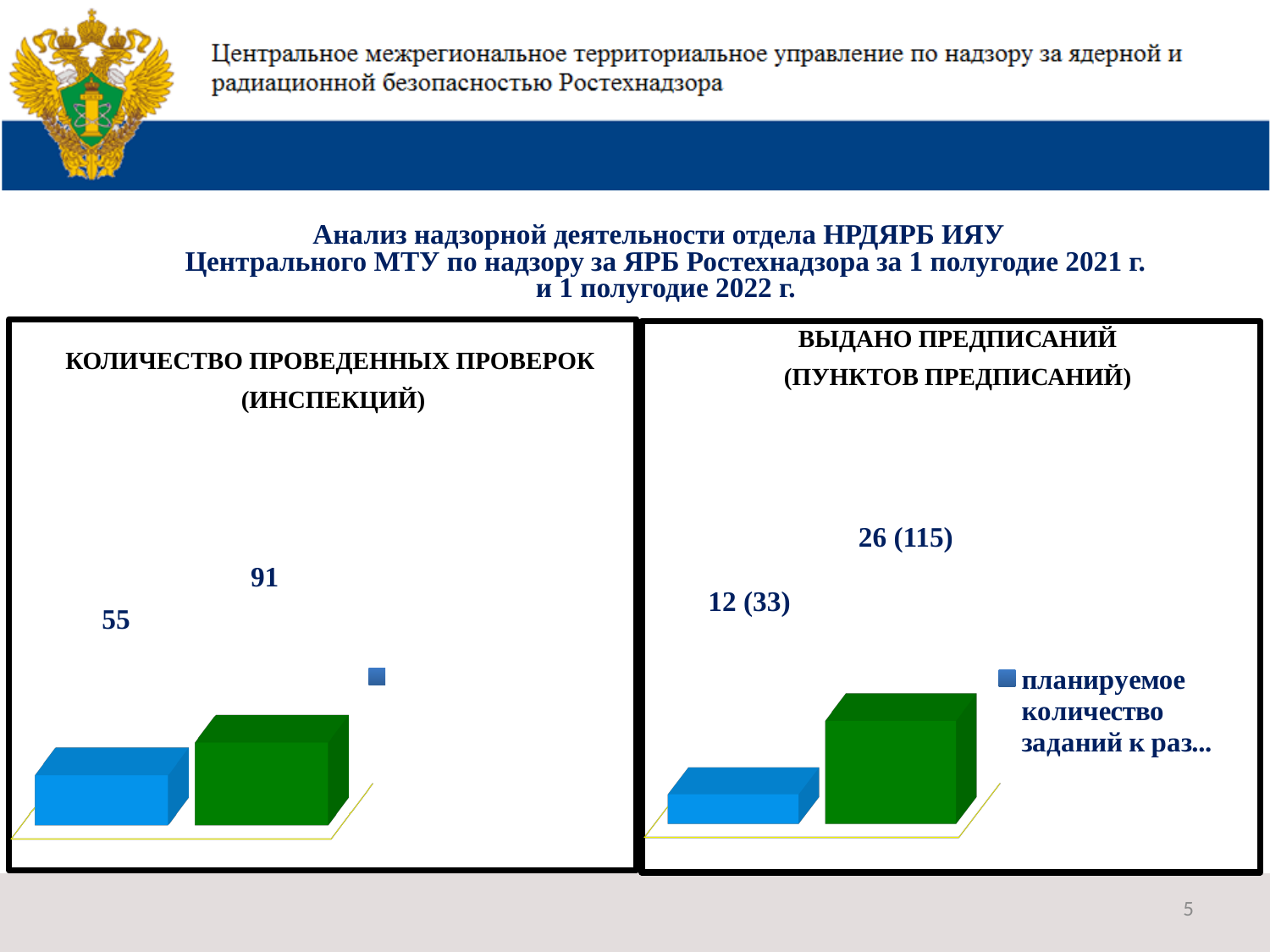
What is the title of the left chart on the slide? КОЛИЧЕСТВО ПРОВЕДЕННЫХ ПРОВЕРОК (ИНСПЕКЦИЙ) In the right chart (ВЫДАНО ПРЕДПИСАНИЙ (ПУНКТОВ ПРЕДПИСАНИЙ)), what is the difference between the number of предписаний on the green bar (26) and on the blue bar (12)? 14 What kind of chart is the left chart (КОЛИЧЕСТВО ПРОВЕДЕННЫХ ПРОВЕРОК (ИНСПЕКЦИЙ))? bar chart How many bars are plotted in the right chart (ВЫДАНО ПРЕДПИСАНИЙ (ПУНКТОВ ПРЕДПИСАНИЙ))? 2 In the left chart (КОЛИЧЕСТВО ПРОВЕДЕННЫХ ПРОВЕРОК (ИНСПЕКЦИЙ)), what is the difference between the green bar and the blue bar? 36 In the left chart (КОЛИЧЕСТВО ПРОВЕДЕННЫХ ПРОВЕРОК (ИНСПЕКЦИЙ)), what value is labelled on the green bar? 91 How many bars are plotted in the left chart (КОЛИЧЕСТВО ПРОВЕДЕННЫХ ПРОВЕРОК (ИНСПЕКЦИЙ))? 2 In the right chart (ВЫДАНО ПРЕДПИСАНИЙ (ПУНКТОВ ПРЕДПИСАНИЙ)), which bar is larger, the blue one or the green one? the green bar In the left chart (КОЛИЧЕСТВО ПРОВЕДЕННЫХ ПРОВЕРОК (ИНСПЕКЦИЙ)), what value is labelled on the blue bar? 55 In the right chart (ВЫДАНО ПРЕДПИСАНИЙ (ПУНКТОВ ПРЕДПИСАНИЙ)), what label is shown on the blue bar? 12 (33) In the right chart (ВЫДАНО ПРЕДПИСАНИЙ (ПУНКТОВ ПРЕДПИСАНИЙ)), what label is shown on the green bar? 26 (115) In the left chart (КОЛИЧЕСТВО ПРОВЕДЕННЫХ ПРОВЕРОК (ИНСПЕКЦИЙ)), which bar is the highest? the green bar (91)